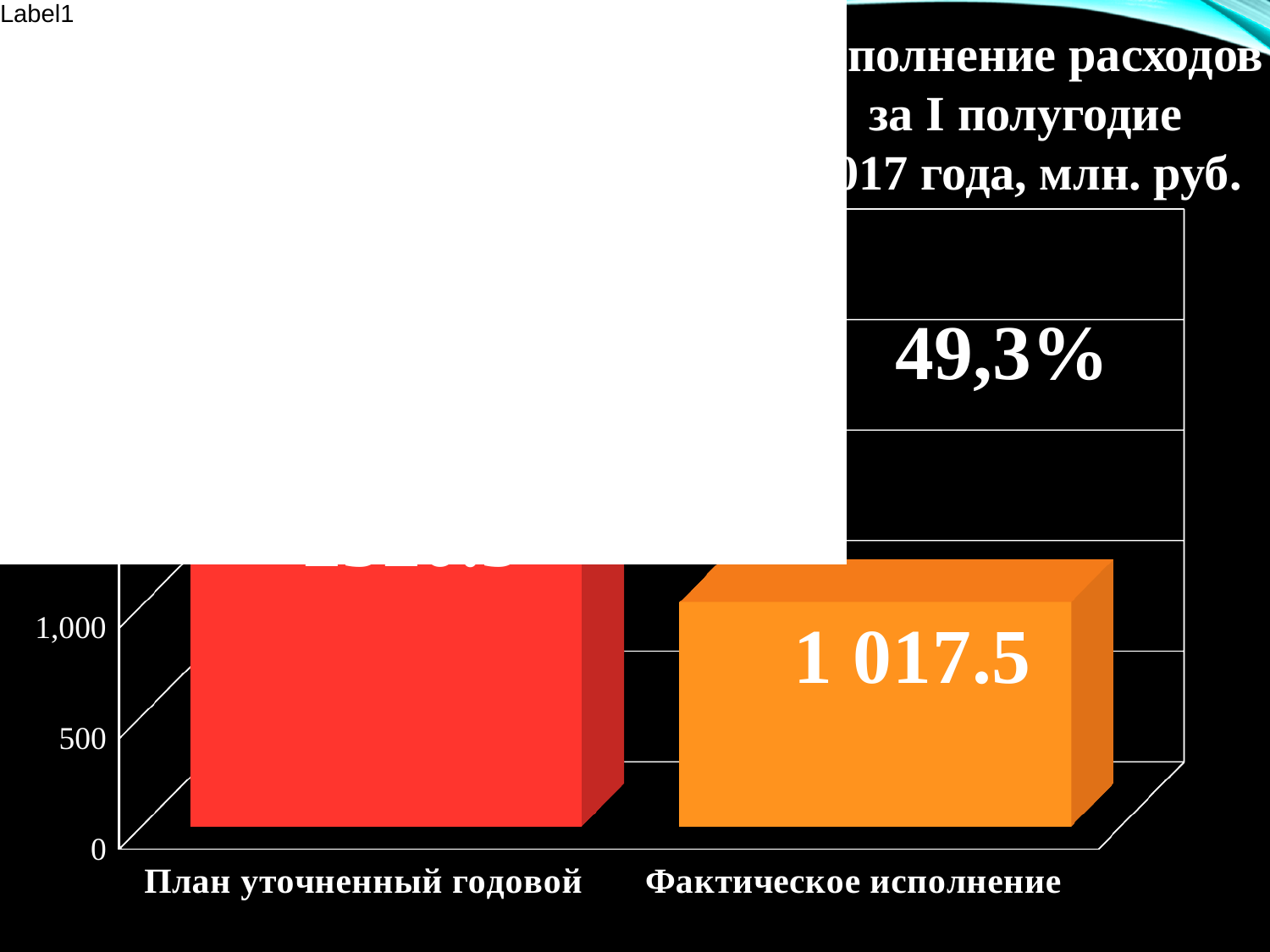
Which category has the highest bar? План уточненный годовой Is the value for План уточненный годовой greater or less than 1,000? greater How many categories are plotted on the chart? 2 Which is larger, the bar for План уточненный годовой or the bar for Фактическое исполнение? План уточненный годовой What colour is the bar for Фактическое исполнение? orange Which category has the lowest bar? Фактическое исполнение Is the value for Фактическое исполнение greater or less than 500? greater What is the value of the bar for Фактическое исполнение? 1 017.5 What colour is the bar for План уточненный годовой? red Do the bar values rise or fall from left to right along the x axis? fall What kind of chart is shown on the slide? bar chart